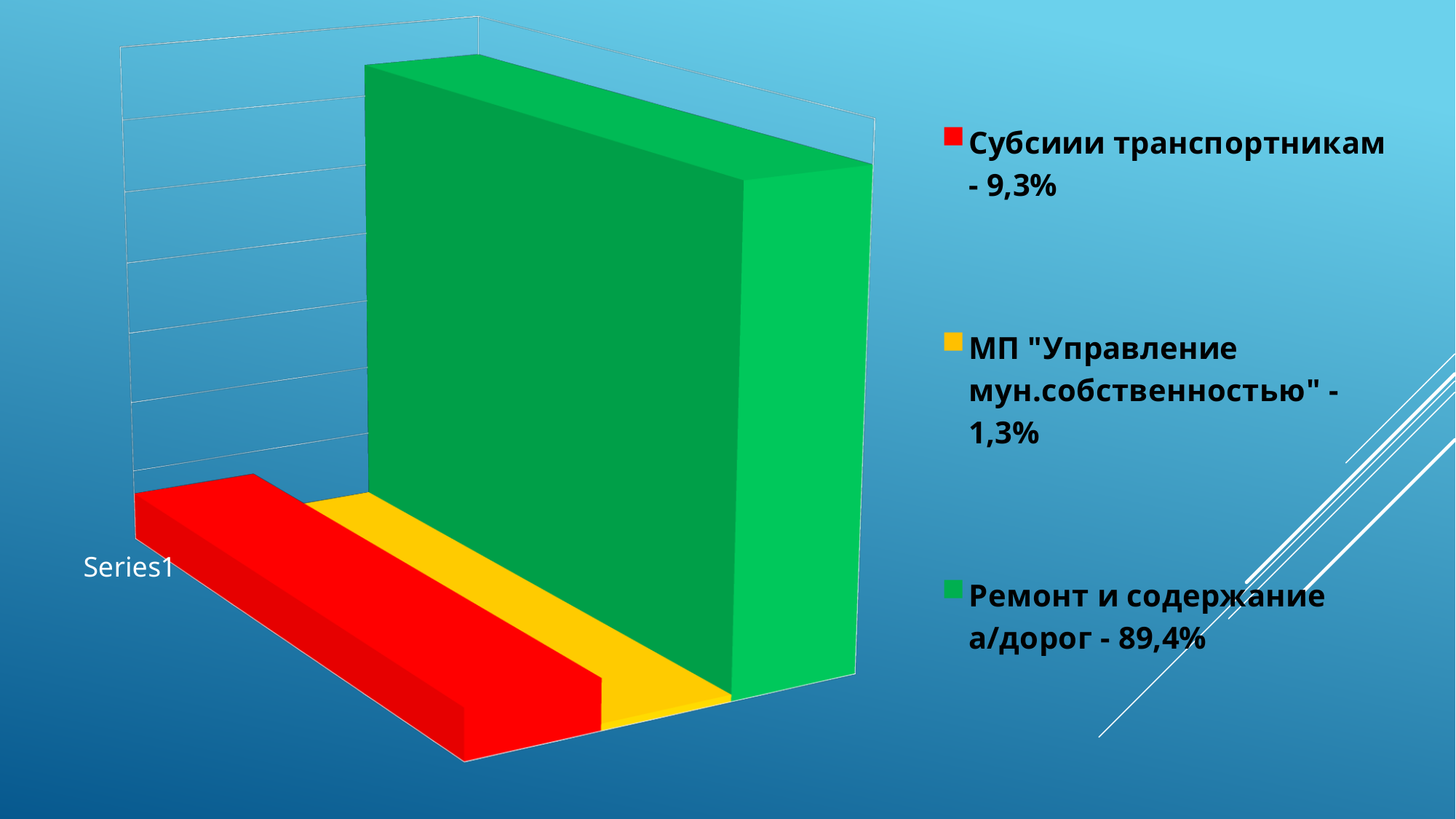
How many series does the legend list? 3 What colour is the bar for Ремонт и содержание а/дорог? green What is the value for Ремонт и содержание а/дорог? 89,4% What is the value for МП "Управление мун.собственностью"? 1,3% Which legend entry has the lowest value? МП "Управление мун.собственностью" What is the category label shown on the horizontal axis? Series1 Which legend entry has the highest value? Ремонт и содержание а/дорог What is the difference between the values for Субсиии транспортникам and МП "Управление мун.собственностью"? 8,0% Which is larger: the value for Субсиии транспортникам or the value for МП "Управление мун.собственностью"? Субсиии транспортникам What is the difference between the values for Ремонт и содержание а/дорог and Субсиии транспортникам? 80,1% What is the value for Субсиии транспортникам? 9,3% What kind of chart is shown on the slide? bar chart